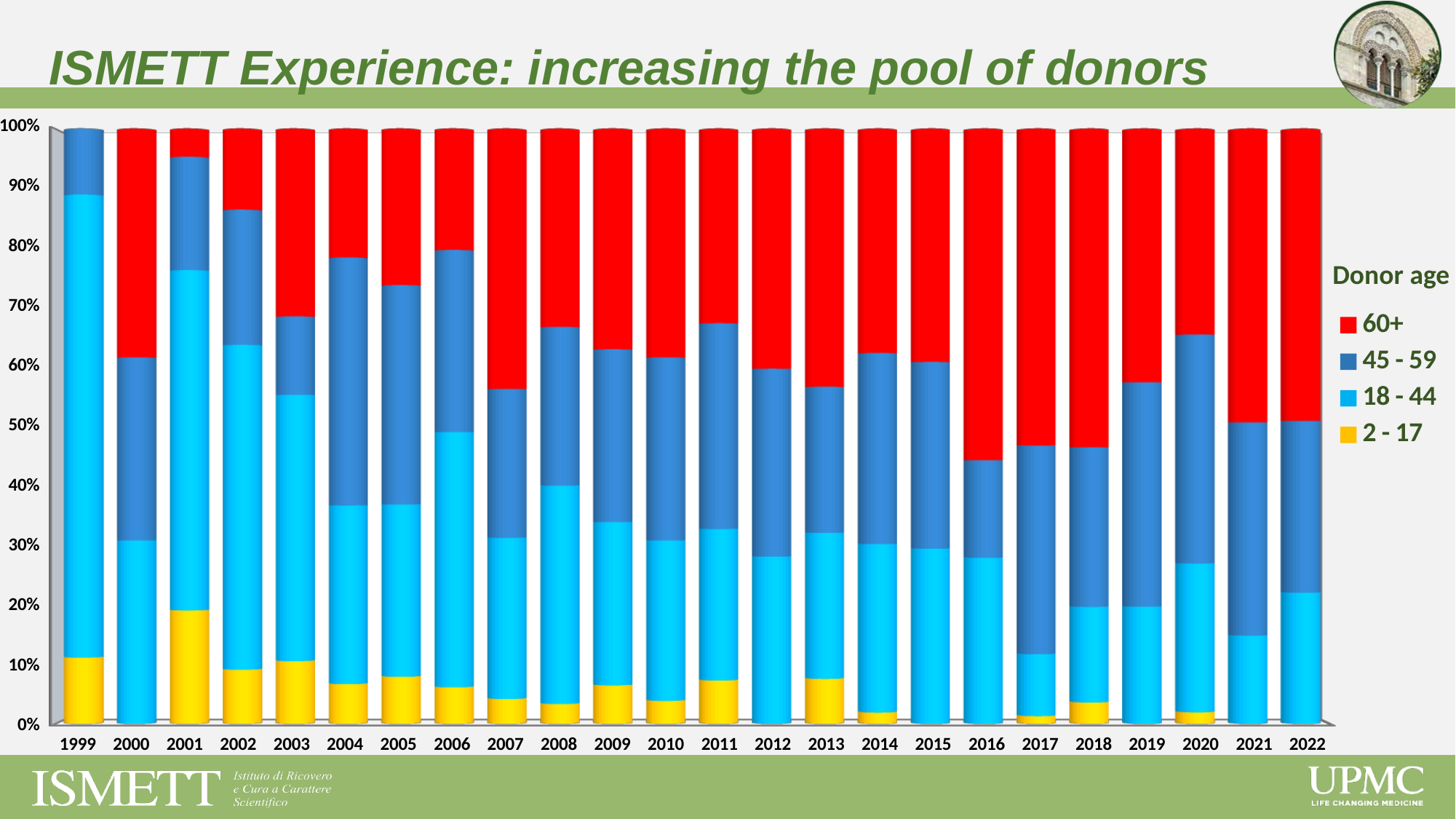
Which year has the largest share of donors aged 2 - 17? 2001 Is the share of donors aged 2 - 17 in 2001 greater or less than 10%? greater Which year has the largest share of donors aged 18 - 44? 1999 Which year has a larger share of donors aged 60+, 2000 or 2022? 2022 How many donor age groups does the legend list? 4 How many years are shown along the x axis of the chart? 24 What is the title of the legend on the chart? Donor age Which colour represents the 60+ donor age group? Red Is the share of donors aged 60+ in 2016 greater or less than 50%? greater Does the share of donors aged 60+ generally rise or fall from 1999 to 2022? Rise Which year has the smallest share of donors aged 60+? 1999 What kind of chart is shown on the slide? Stacked bar chart